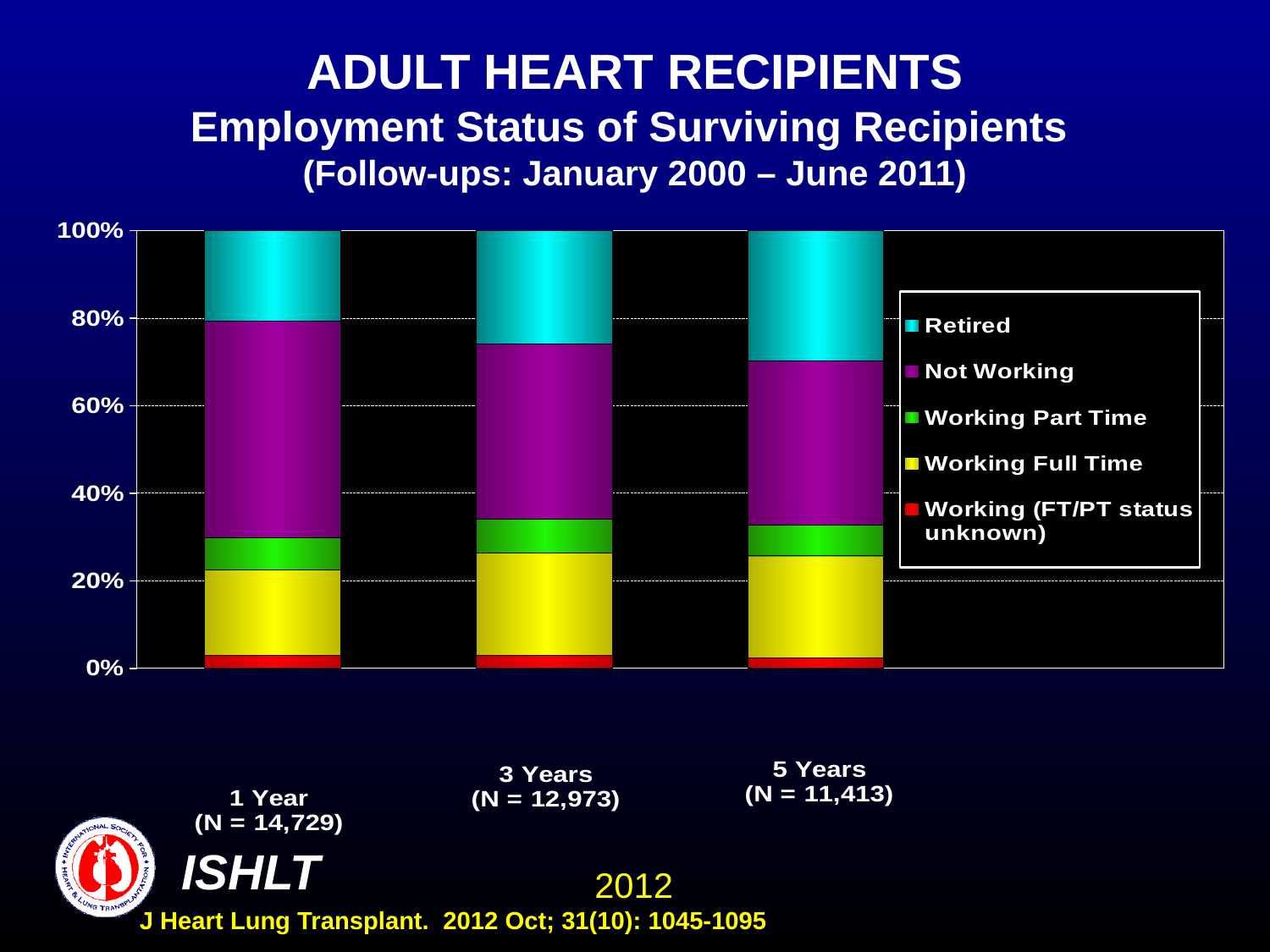
Is the Retired share larger at 1 Year or at 5 Years? 5 Years How many series does the legend list? 5 Is the Retired share at 5 Years greater or less than 20%? greater At which follow-up time point is the Not Working segment smallest? 5 Years What is the N shown for the 1 Year follow-up? 14,729 Does the Retired share rise or fall from 1 Year to 5 Years? Rise How many follow-up time points (categories) are plotted on the x axis? 3 Is the Not Working share at 1 Year greater or less than 40%? greater At which follow-up time point is the Retired segment largest? 5 Years Which employment status series is the largest segment in the 1 Year bar? Not Working What kind of chart is shown on the slide? Stacked bar chart Is the Not Working share larger at 1 Year or at 5 Years? 1 Year